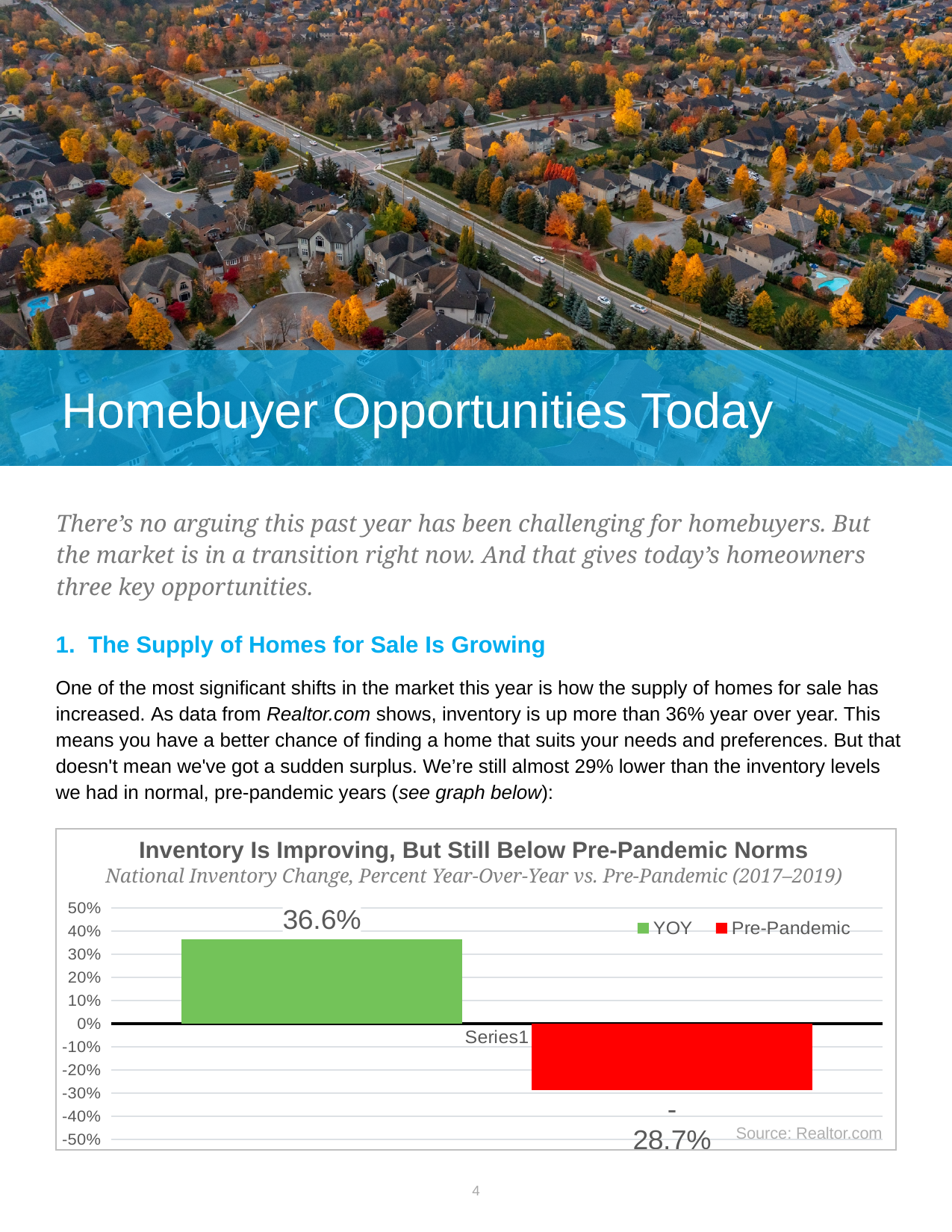
How many series does the legend list? 2 Is the Pre-Pandemic value greater or less than -20%? less What is the Pre-Pandemic value shown on the chart? -28.7% What kind of chart is shown on the slide? Bar chart Is the YOY value greater or less than 30%? greater What is the YOY value shown on the chart? 36.6% Which series has the lowest value on the chart? Pre-Pandemic What is the difference between the YOY value and the Pre-Pandemic value? 65.3 percentage points Which series has the higher value, YOY or Pre-Pandemic? YOY Which series has the highest value on the chart? YOY What is the title of the chart? Inventory Is Improving, But Still Below Pre-Pandemic Norms What colour is the Pre-Pandemic bar? Red